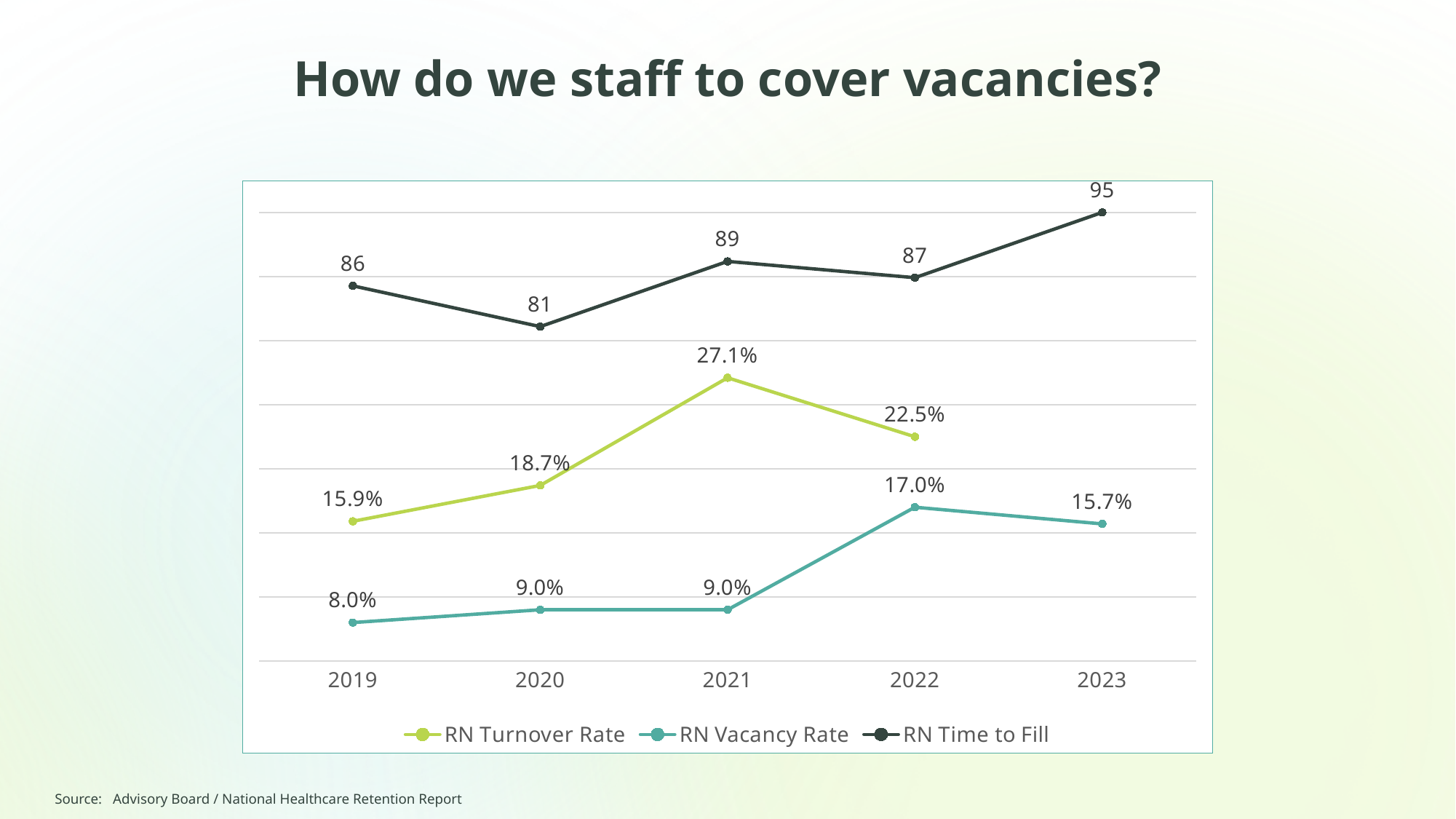
Does the RN Vacancy Rate rise or fall from 2022 to 2023? fall By how much did the RN Time to Fill increase from 2022 to 2023? 8 How many series does the legend list? 3 In which year is the RN Vacancy Rate lowest? 2019 What is the RN Time to Fill value for 2020? 81 Which is larger, the RN Turnover Rate in 2019 or the RN Vacancy Rate in 2022? RN Vacancy Rate in 2022 What kind of chart is shown on the slide? line chart How many years are shown on the x axis? 5 What is the RN Turnover Rate in 2021? 27.1% What is the RN Vacancy Rate in 2022? 17.0% What is the difference between the RN Turnover Rate in 2021 and in 2020? 8.4% In which year is the RN Time to Fill highest? 2023